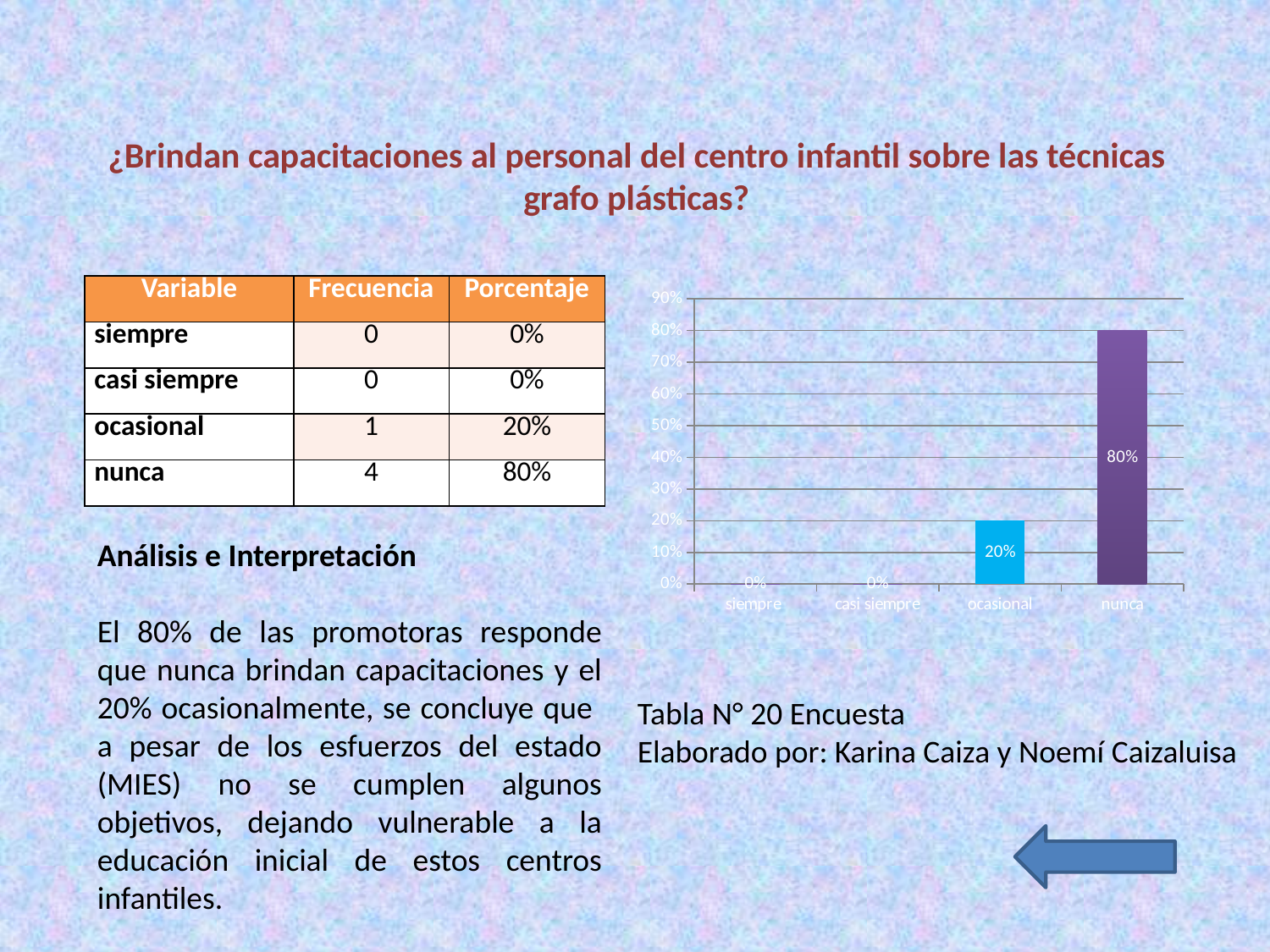
Which category has the highest value in the chart? nunca Is the value for nunca greater or less than 50%? greater Which is larger, the value for ocasional or the value for nunca? nunca What is the difference between the values for nunca and ocasional? 60% What is the value for ocasional in the chart? 20% What kind of chart is shown on the slide? bar chart How many categories are shown on the x axis of the chart? 4 What is the value for nunca in the chart? 80% What is the value for casi siempre in the chart? 0% Is the value for ocasional greater or less than 30%? less What is the value for siempre in the chart? 0% What is the highest value shown on the y axis of the chart? 90%